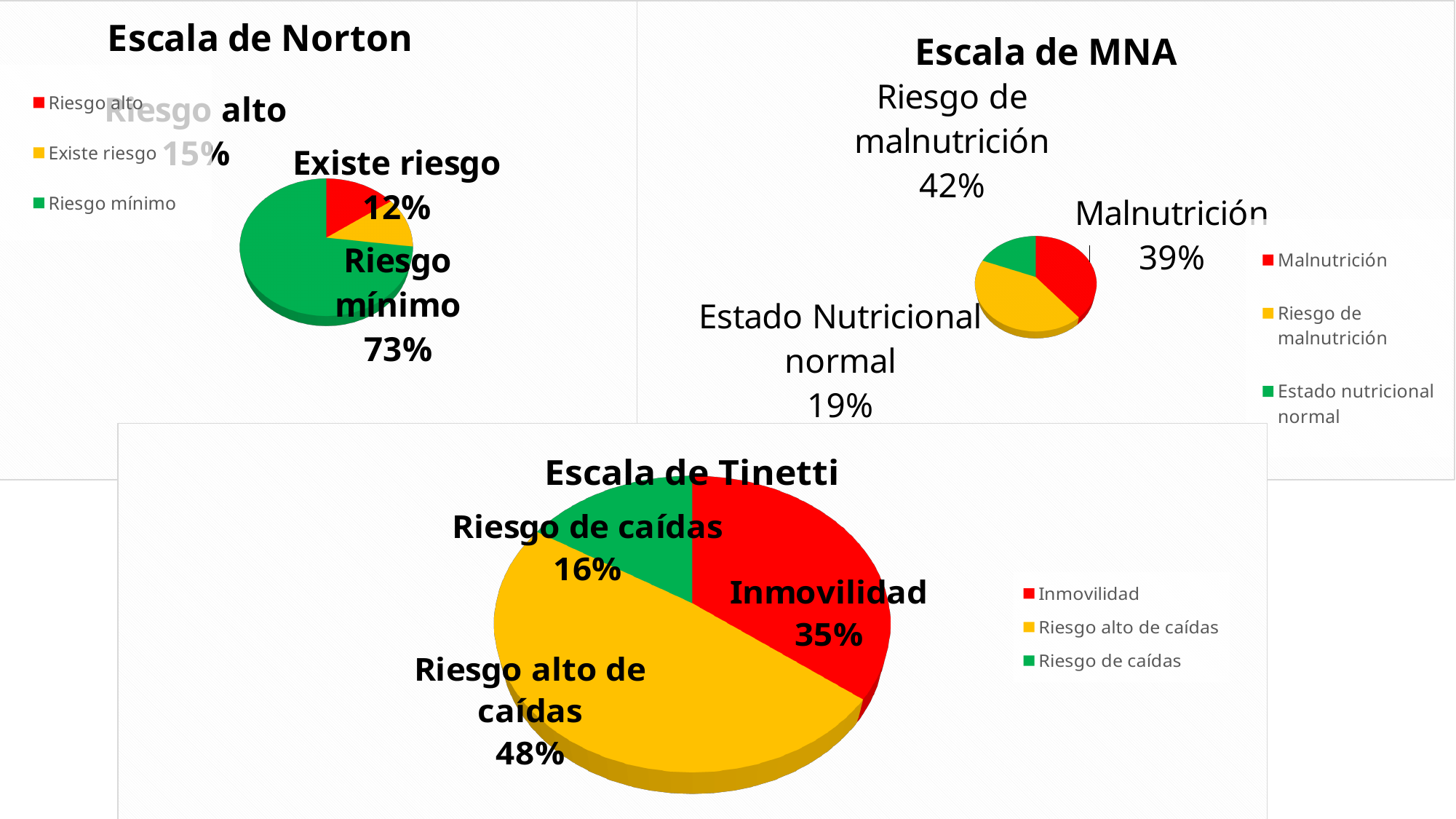
In the Escala de MNA chart, what percentage is labelled for Riesgo de malnutrición? 42% In the Escala de MNA chart, what percentage is labelled for Estado Nutricional normal? 19% In the Escala de MNA chart, which category has the smallest slice? Estado Nutricional normal In the Escala de Norton chart, which category has the largest slice? Riesgo mínimo How many slices does the Escala de Tinetti chart have? 3 In the Escala de Tinetti chart, which is larger, Inmovilidad or Riesgo de caídas? Inmovilidad In the Escala de Norton chart, what percentage is labelled for Existe riesgo? 12% In the Escala de Tinetti chart, what is the difference in percentage points between Riesgo alto de caídas and Inmovilidad? 13 What type of chart is the Escala de Norton chart? Pie chart In the Escala de Tinetti chart, what percentage is labelled for Riesgo alto de caídas? 48% In the Escala de MNA chart, what is the difference in percentage points between Riesgo de malnutrición and Malnutrición? 3 In the Escala de Norton chart, what percentage is labelled for Riesgo mínimo? 73%